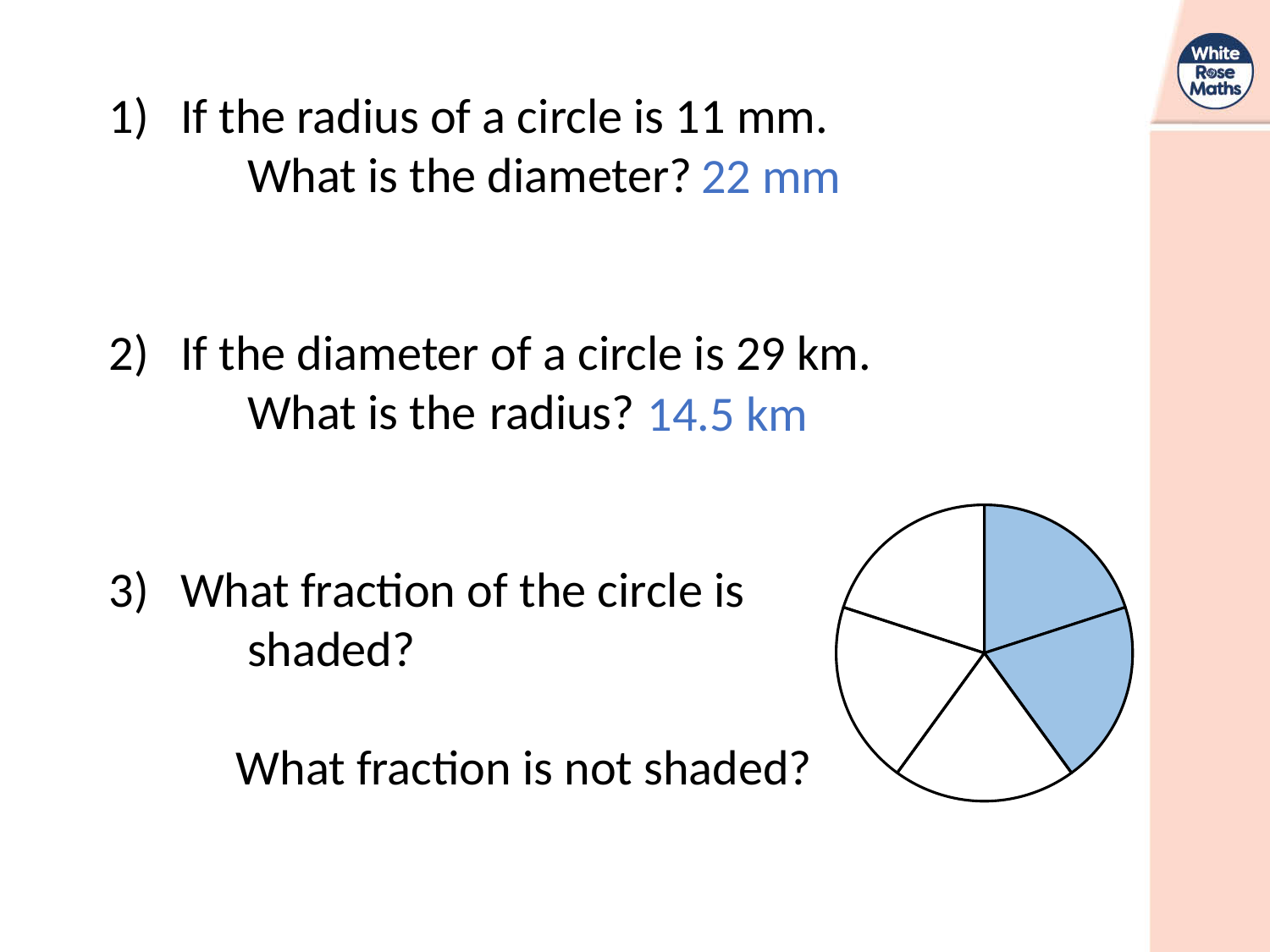
How many sectors of the circle on the slide are not shaded? 3 What colour are the shaded sectors of the circle on the slide? blue How many sectors of the circle on the slide are shaded? 2 Are there more shaded or unshaded sectors in the circle on the slide? unshaded How many equal sectors is the circle on the slide divided into? 5 What fraction of the circle on the slide is not shaded? 3/5 Are the shaded sectors of the circle on the slide next to each other or separated? next to each other What fraction of the circle on the slide is shaded? 2/5